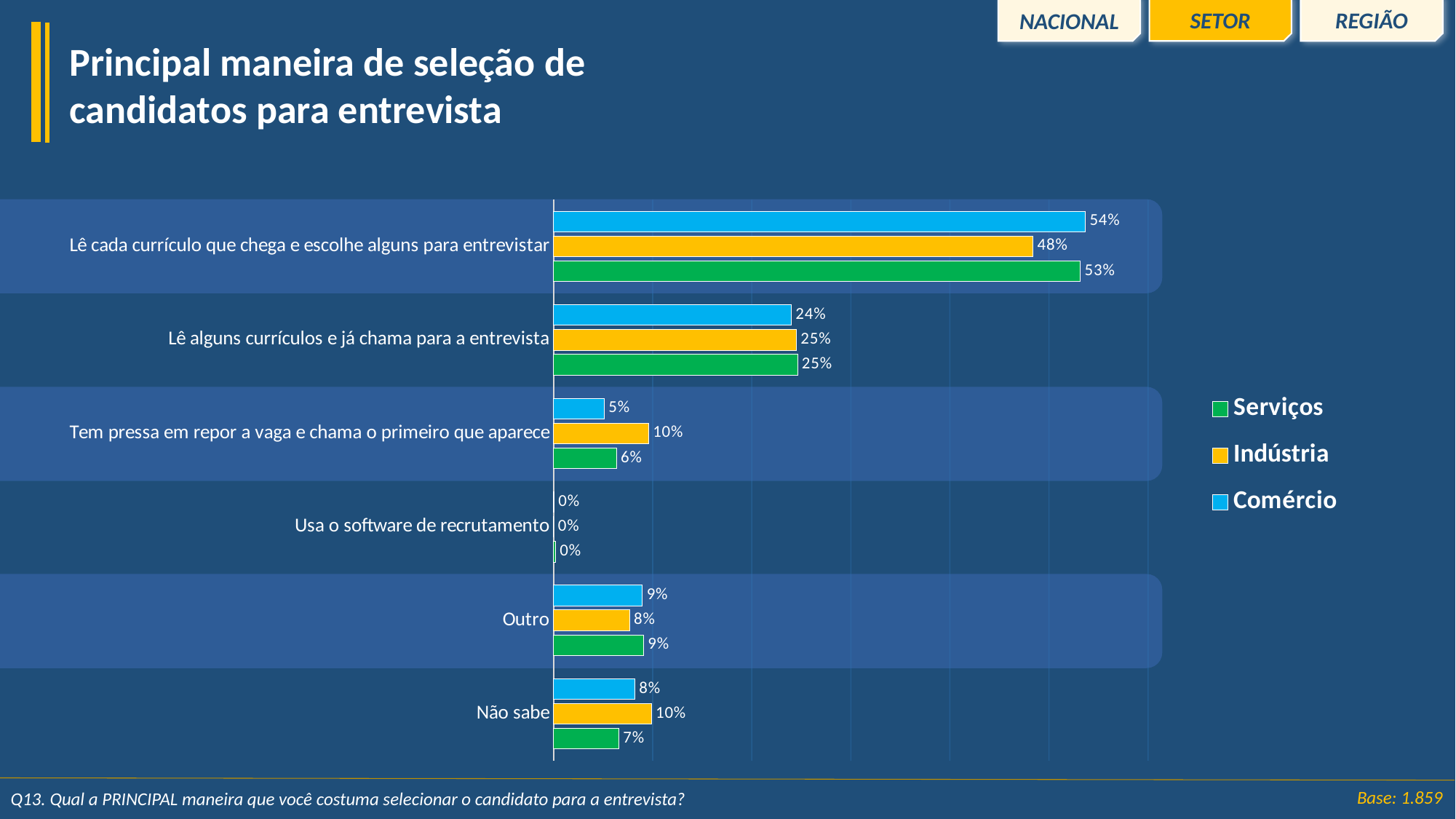
What type of chart is shown on the slide? bar chart What is the value for Comércio in the category 'Lê alguns currículos e já chama para a entrevista'? 24% How many categories are shown on the chart? 6 Which category has the highest value for Serviços? Lê cada currículo que chega e escolhe alguns para entrevistar What is the value for Indústria in the category 'Tem pressa em repor a vaga e chama o primeiro que aparece'? 10% What is the difference between the Comércio and Indústria values in the category 'Lê cada currículo que chega e escolhe alguns para entrevistar'? 6% In the category 'Tem pressa em repor a vaga e chama o primeiro que aparece', which is larger: the value for Indústria or the value for Comércio? Indústria What is the value for Comércio in the category 'Lê cada currículo que chega e escolhe alguns para entrevistar'? 54% What is the value for Serviços in the category 'Não sabe'? 7% How many series does the legend list? 3 Which series is shown in green in the legend? Serviços Which category has the lowest value for Indústria? Usa o software de recrutamento